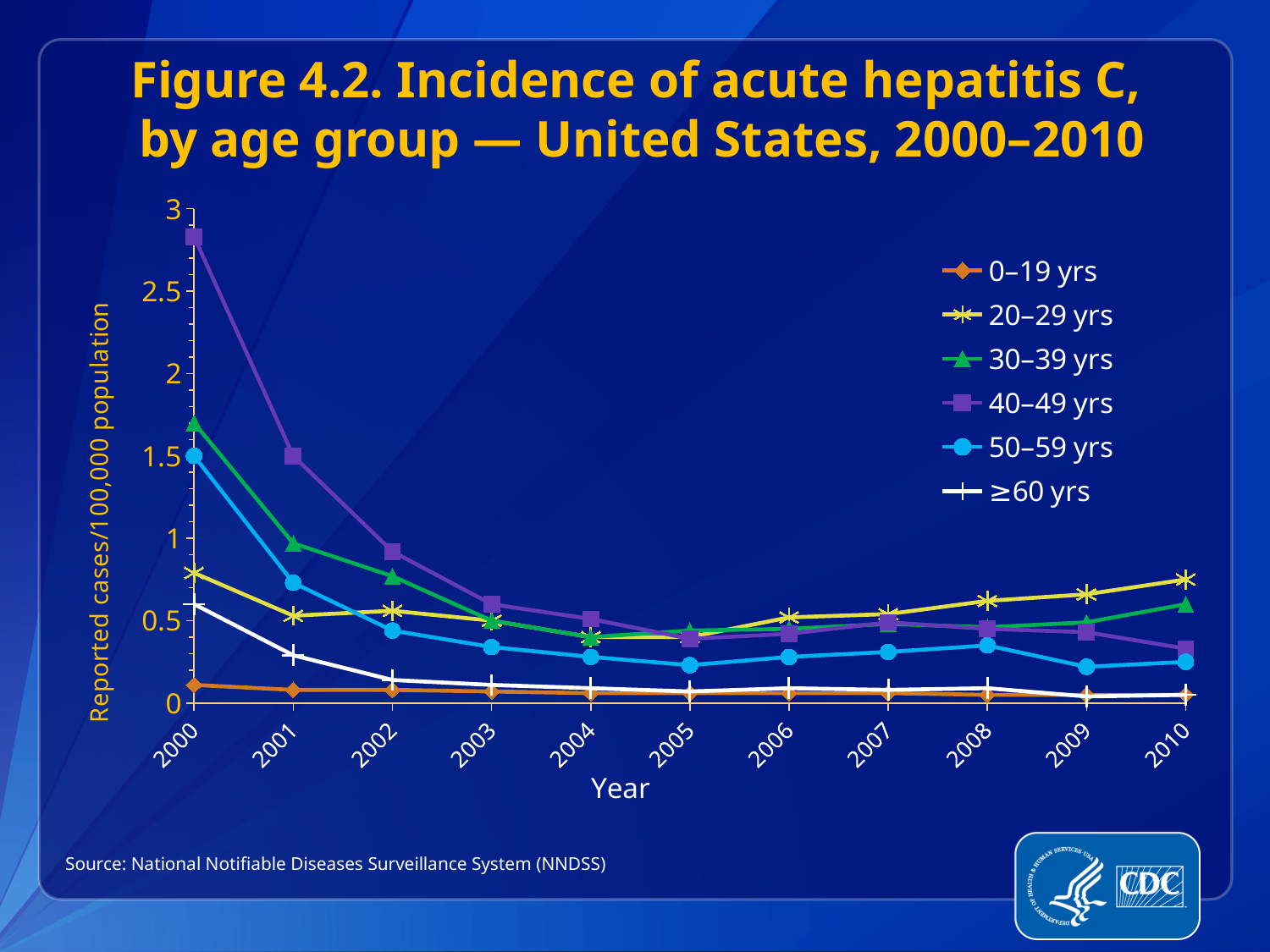
Which age group had the lowest incidence in 2000? 0–19 yrs How many years are plotted along the x axis? 11 Which age group had the highest incidence in 2010? 20–29 yrs Is the value for 40–49 yrs in 2000 greater or less than 2.5? greater In 2000, which had the higher incidence: 30–39 yrs or 50–59 yrs? 30–39 yrs How many series does the legend list? 6 Is the value for 0–19 yrs in 2000 greater or less than 0.5? less Does the incidence for 40–49 yrs rise or fall from 2000 to 2010? fall Which age group had the highest incidence in 2000? 40–49 yrs Is the value for 20–29 yrs in 2010 greater or less than 0.5? greater What kind of chart is shown on the slide? line chart